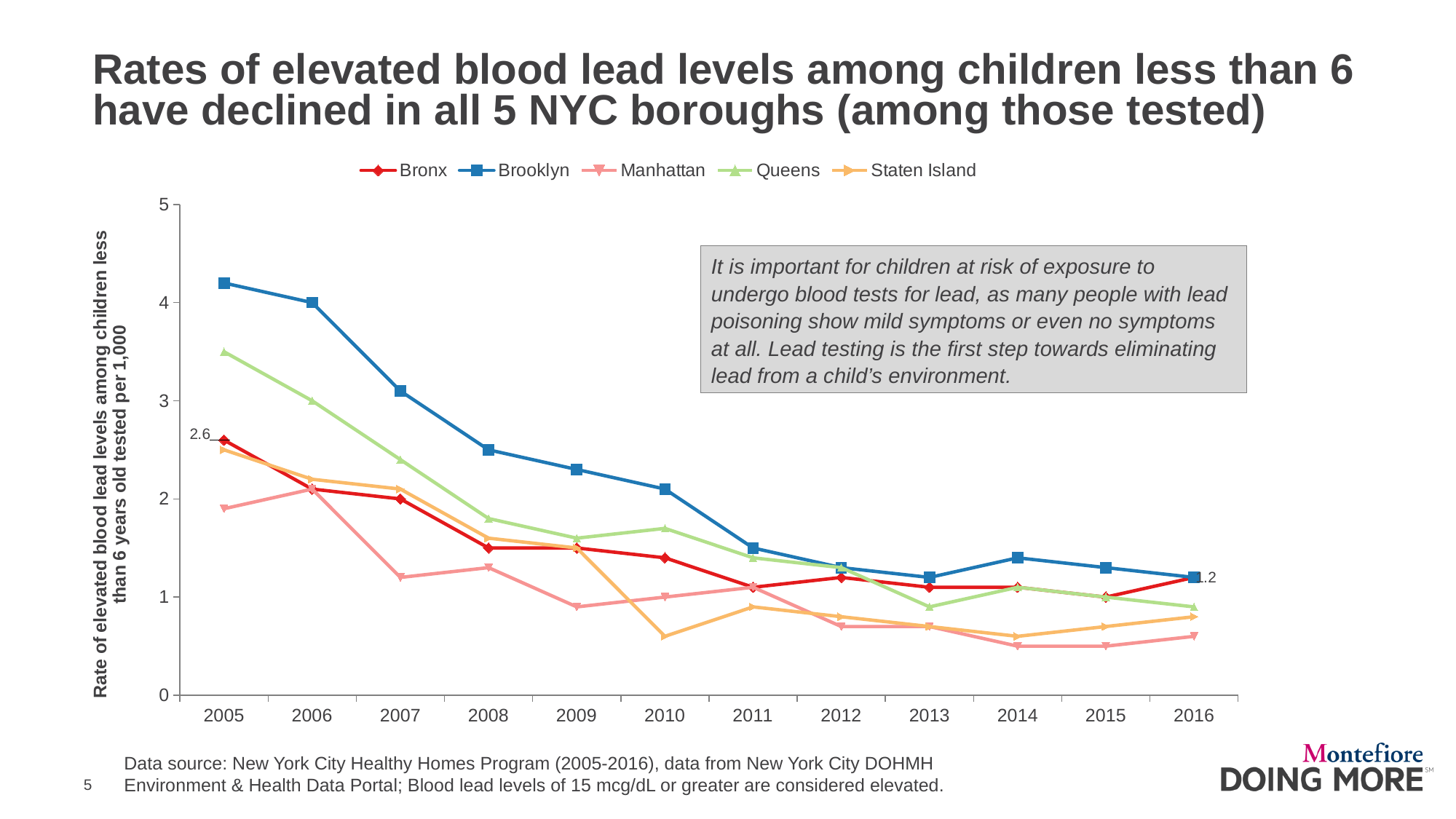
How many years are shown along the x axis? 12 What is the rate for the Bronx in 2005? 2.6 By how much did the Bronx rate fall from 2005 to 2016? 1.4 Is the value for Brooklyn in 2005 greater or less than 4? greater Which borough had the lowest rate in 2005? Manhattan Which borough had the highest rate in 2005? Brooklyn How many series does the legend list? 5 In 2010, which is larger: the rate for Brooklyn or the rate for Manhattan? Brooklyn What is the rate for the Bronx in 2016? 1.2 Is the value for Manhattan in 2014 greater or less than 1? less What kind of chart is shown on the slide? line chart Does the Brooklyn line generally rise or fall from 2005 to 2016? fall